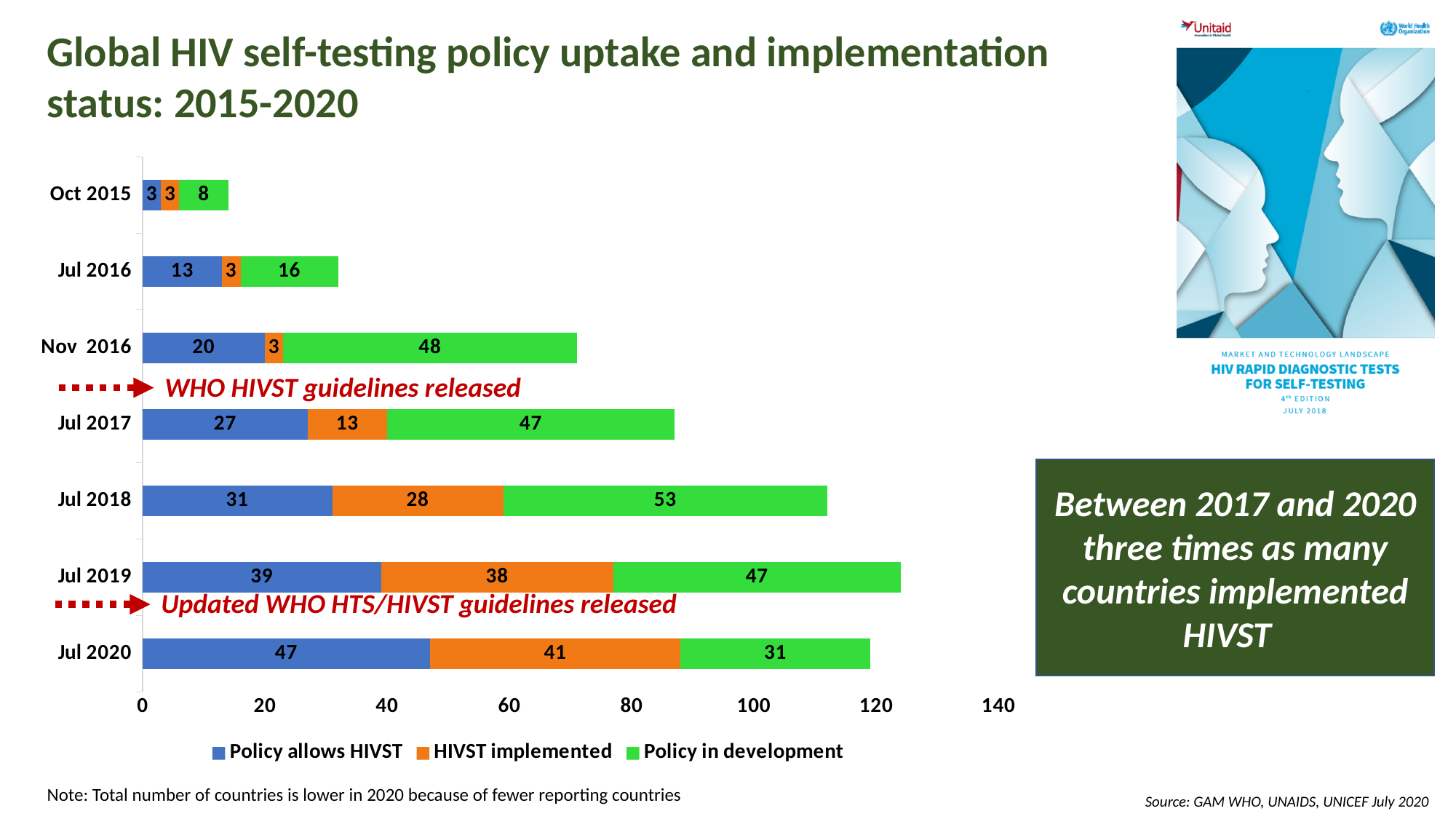
What is the value for 'HIVST implemented' in Jul 2019? 38 What is the value for 'Policy in development' in Nov 2016? 48 What is the total of the stacked bar for Jul 2019? 124 Which period has the highest value for 'Policy allows HIVST'? Jul 2020 How many time periods are shown on the chart? 7 How many series does the legend list? 3 What is the total of the stacked bar for Oct 2015? 14 Which period has the lowest value for 'Policy in development'? Oct 2015 What kind of chart is shown on the slide? Stacked bar chart Which is larger: 'Policy in development' in Jul 2018 or in Jul 2019? Jul 2018 What is the difference between the 'HIVST implemented' values for Jul 2020 and Jul 2017? 28 What is the value for 'Policy allows HIVST' in Jul 2020? 47